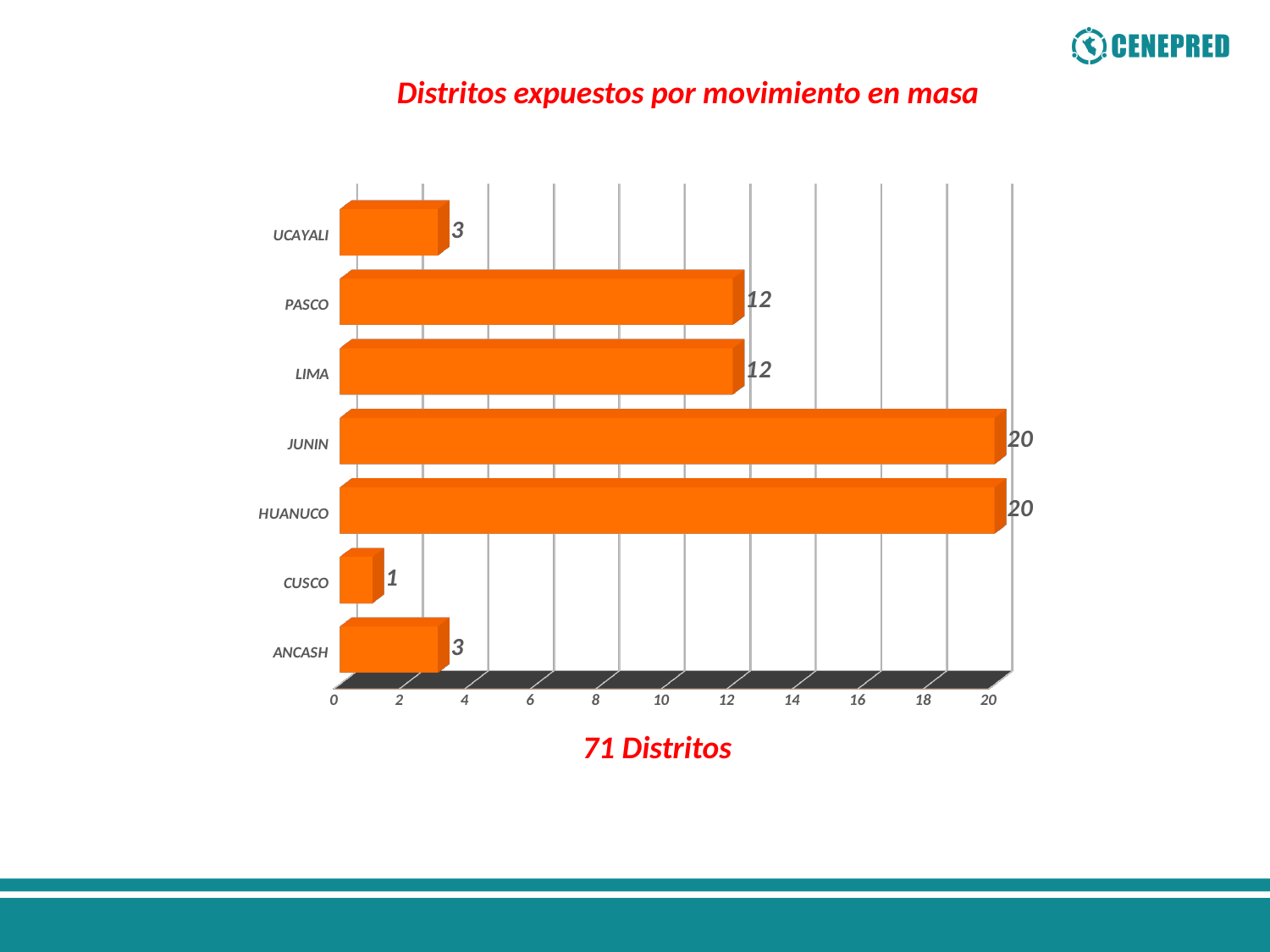
Which is larger, the value for HUANUCO or the value for PASCO? HUANUCO Which is larger, the value for UCAYALI or the value for CUSCO? UCAYALI What is the value for PASCO? 12 What is the difference between the values for JUNIN and LIMA? 8 Which category has the lowest value? CUSCO What is the value for UCAYALI? 3 How many categories are shown in the chart? 7 What is the title of the chart? Distritos expuestos por movimiento en masa What total number of districts is stated below the chart? 71 Distritos What is the value for CUSCO? 1 What kind of chart is shown on the slide? bar chart What is the difference between the values for ANCASH and CUSCO? 2